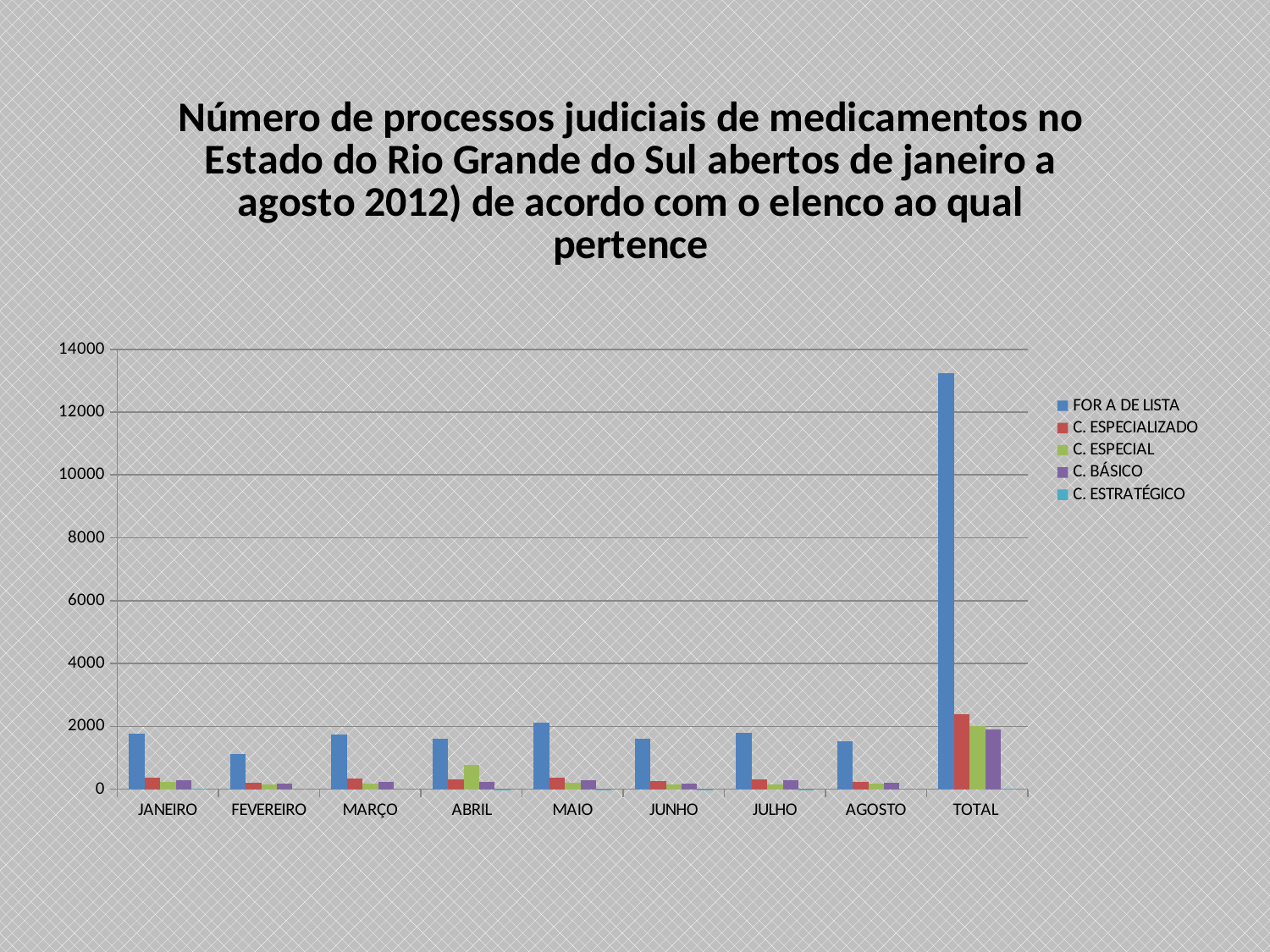
Is the FOR A DE LISTA value for FEVEREIRO greater or less than 2000? less Is the FOR A DE LISTA value for MAIO greater or less than 4000? less Which series has the shortest bar in the TOTAL category? C. ESTRATÉGICO What kind of chart is shown on the slide? bar chart Among the months JANEIRO to AGOSTO, which has the lowest FOR A DE LISTA value? FEVEREIRO In ABRIL, which is larger: C. ESPECIAL or C. ESPECIALIZADO? C. ESPECIAL In JANEIRO, which is larger: FOR A DE LISTA or C. BÁSICO? FOR A DE LISTA Which series has the tallest bar in the TOTAL category? FOR A DE LISTA Is the FOR A DE LISTA value for TOTAL greater or less than 12000? greater How many categories are shown along the x axis? 9 Which series is shown in blue in the legend? FOR A DE LISTA How many series does the legend list? 5